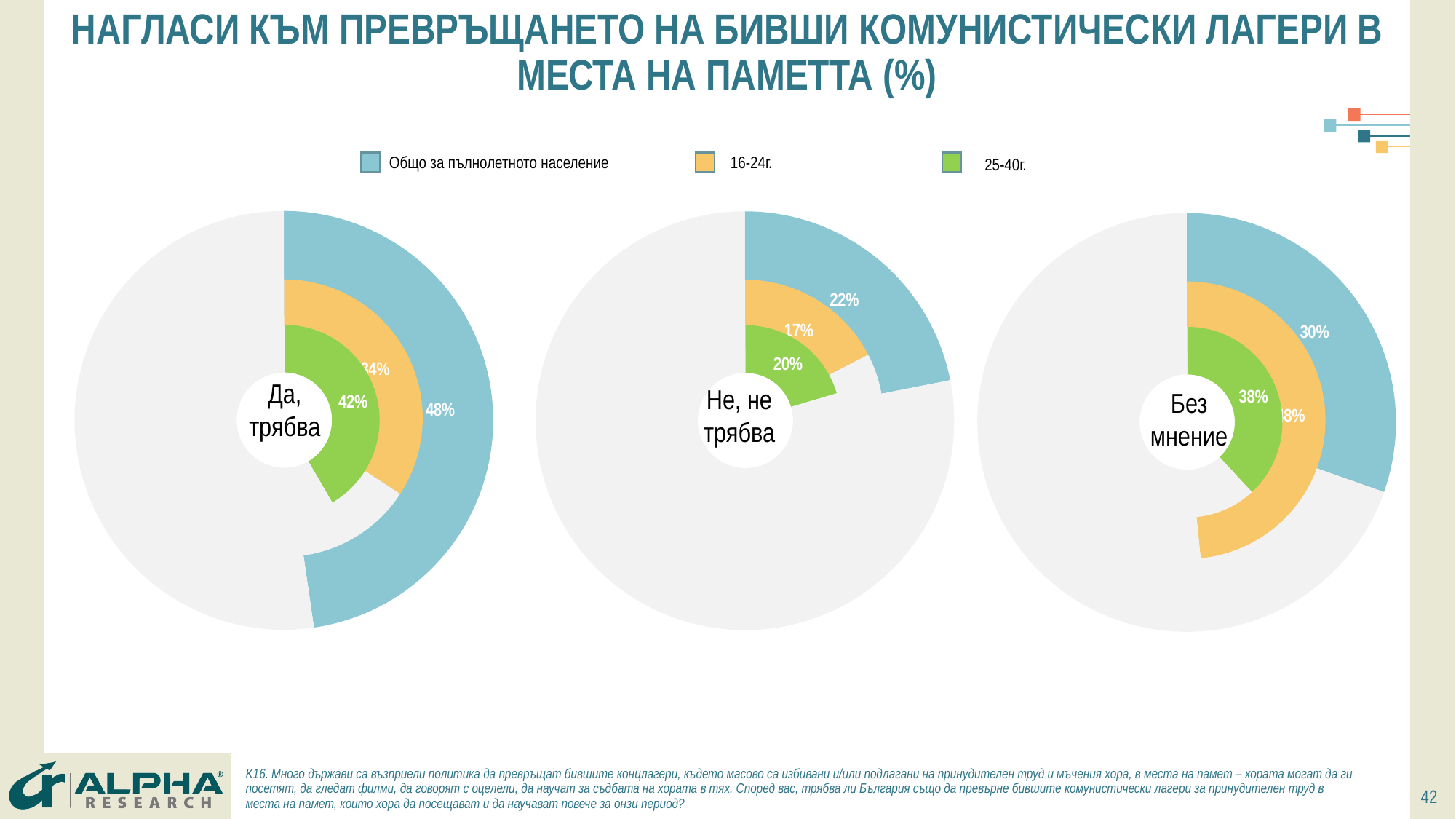
How many series does the legend list? 3 In the 'Без мнение' chart, which is larger: the value for 25-40г. or for Общо за пълнолетното население? 25-40г. In the 'Не, не трябва' chart, what is the value for 16-24г.? 17% In the 'Да, трябва' chart, which series has the highest value? Общо за пълнолетното население In the 'Не, не трябва' chart, which series has the lowest value? 16-24г. In the 'Без мнение' chart, what is the value for 25-40г.? 38% In the 'Не, не трябва' chart, what is the value for Общо за пълнолетното население? 22% What kind of charts are shown on the slide? Donut (pie) charts In the 'Да, трябва' chart, what is the value for 25-40г.? 42% In the 'Да, трябва' chart, what is the value for Общо за пълнолетното население? 48% In the 'Без мнение' chart, what is the value for Общо за пълнолетното население? 30% In the 'Не, не трябва' chart, what is the difference between the values for Общо за пълнолетното население and 25-40г.? 2%